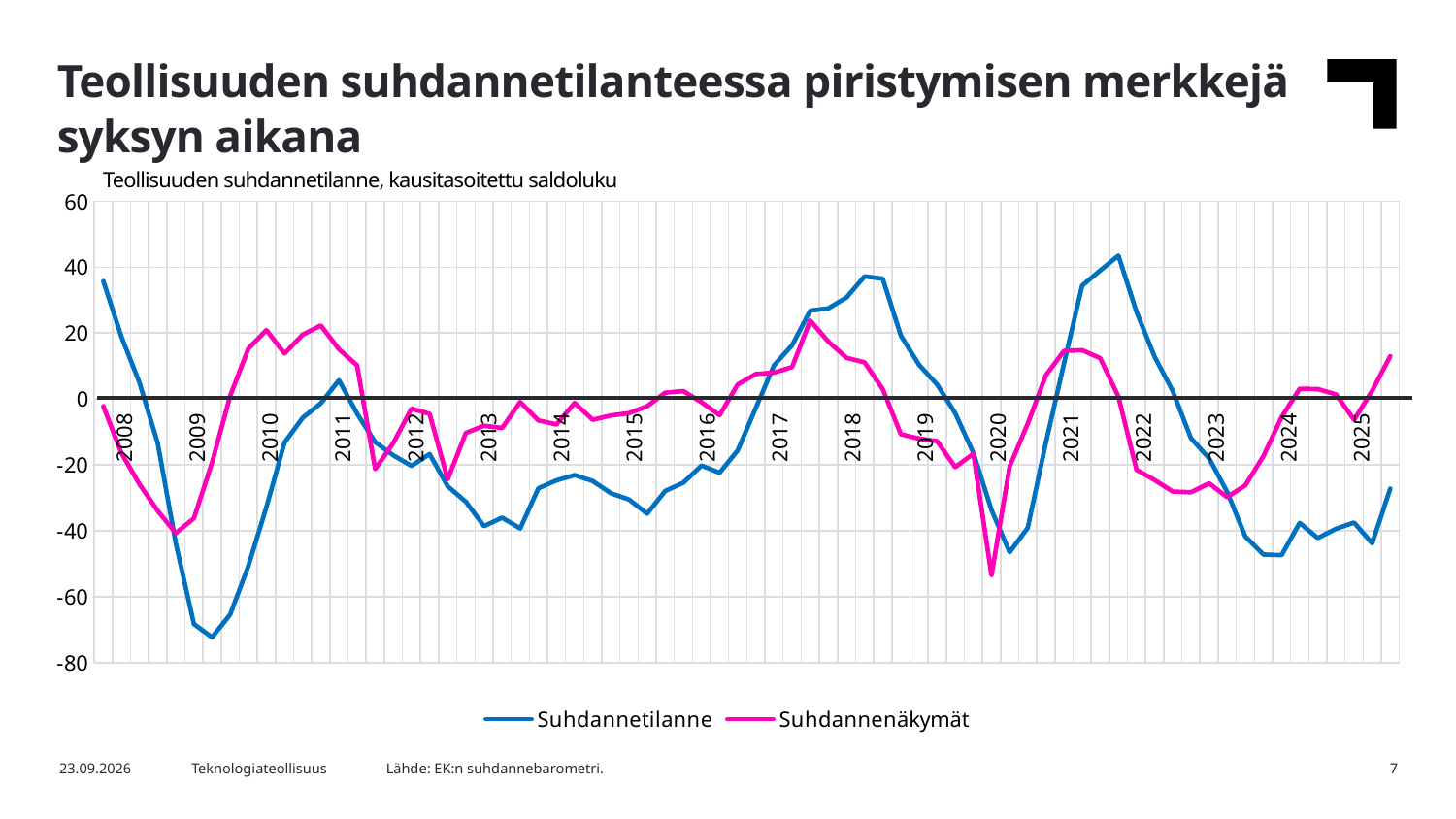
What kind of chart is shown on the slide? Line chart In which year does the Suhdannetilanne line reach its lowest point? 2009 What are the two series named in the legend? Suhdannetilanne and Suhdannenäkymät How many series does the legend list? 2 Is the lowest value of the Suhdannetilanne line, reached in 2009, greater or less than -60? less How many year labels are shown on the x axis? 18 Is the lowest value of the Suhdannenäkymät line, reached in 2020, greater or less than -40? less Is the peak of the Suhdannetilanne line in 2018 greater or less than 20? greater What is the subtitle printed above the chart? Teollisuuden suhdannetilanne, kausitasoitettu saldoluku Does the Suhdannetilanne line rise or fall between its 2021 peak and 2023? fall